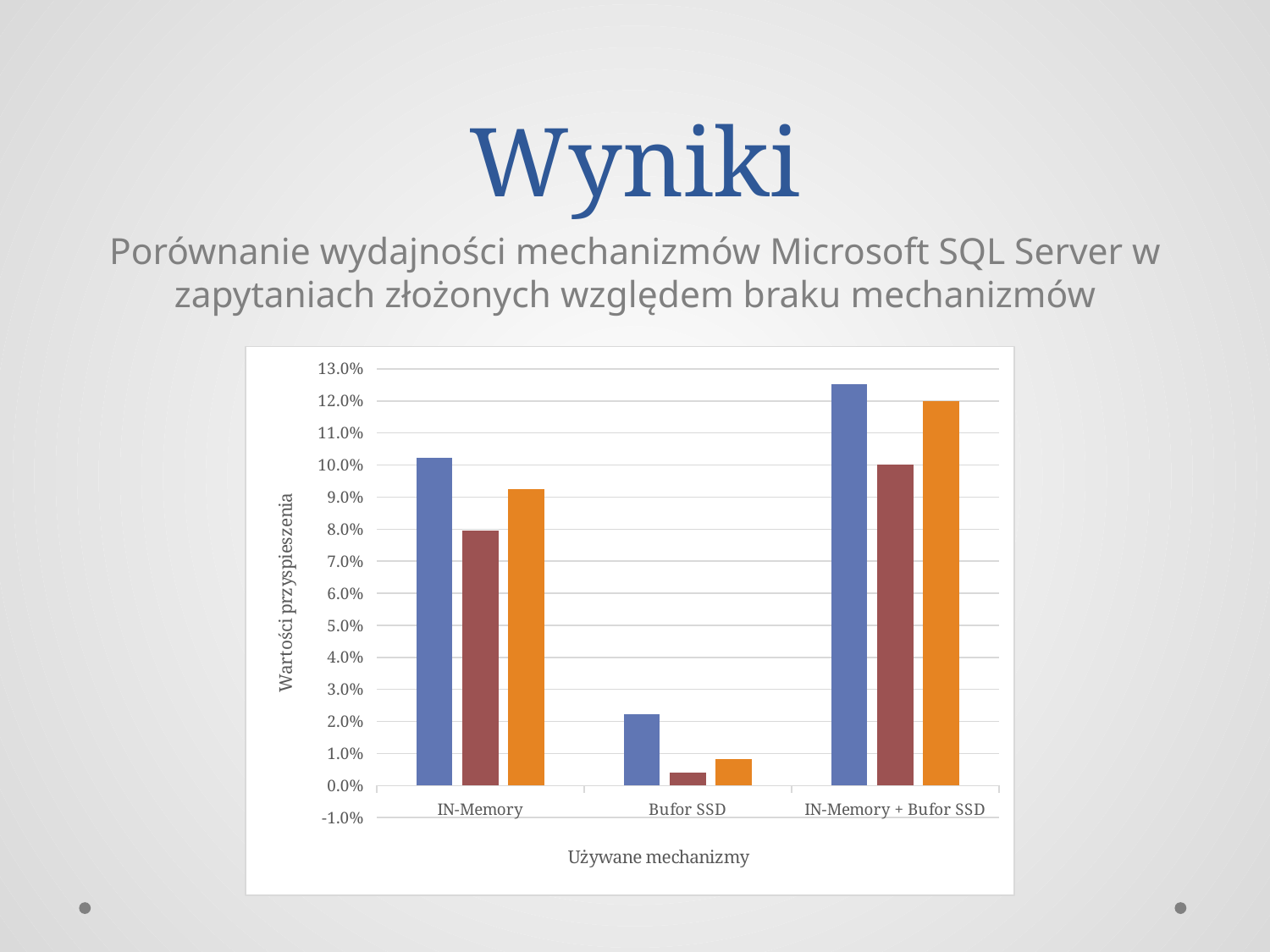
Is the blue bar for IN-Memory greater or less than 9.0%? greater How many categories are shown on the x axis of the chart? 3 What is the label of the horizontal axis of the chart? Używane mechanizmy What kind of chart is shown on the slide? bar chart How many bars are plotted for each category in the chart? 3 For the IN-Memory category, is the blue bar or the red bar taller? blue Is the blue bar for IN-Memory + Bufor SSD greater or less than 12.0%? greater Is the blue bar for Bufor SSD greater or less than 3.0%? less Which category has the shortest bars overall? Bufor SSD What is the label of the vertical axis of the chart? Wartości przyspieszenia Which category has the tallest blue bar? IN-Memory + Bufor SSD